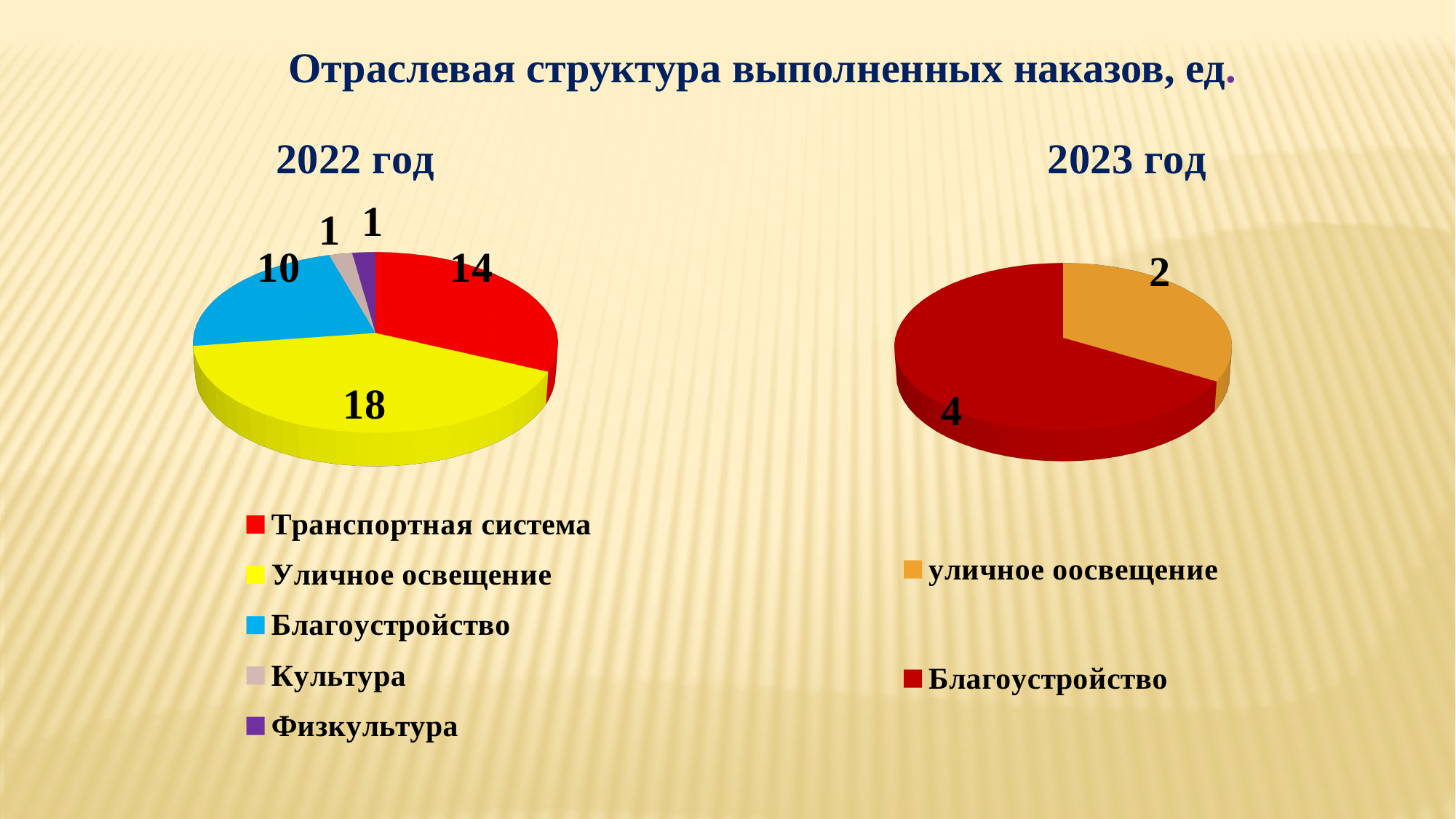
In the 2022 год pie chart, what is the value for Уличное освещение? 18 How many categories does the 2022 год pie chart show? 5 In the 2023 год pie chart, which category has the smallest value? уличное оосвещение What type of chart is used for 2023 год? Pie chart In the 2022 год pie chart, which category has the largest value? Уличное освещение In the 2022 год pie chart, what is the value for Транспортная система? 14 In the 2022 год pie chart, which is larger: Транспортная система or Благоустройство? Транспортная система In the 2023 год pie chart, what is the difference between Благоустройство and уличное оосвещение? 2 In the 2023 год pie chart, what is the value for Благоустройство? 4 In the 2022 год pie chart, what is the difference between Уличное освещение and Транспортная система? 4 In the 2022 год pie chart, what is the value for Благоустройство? 10